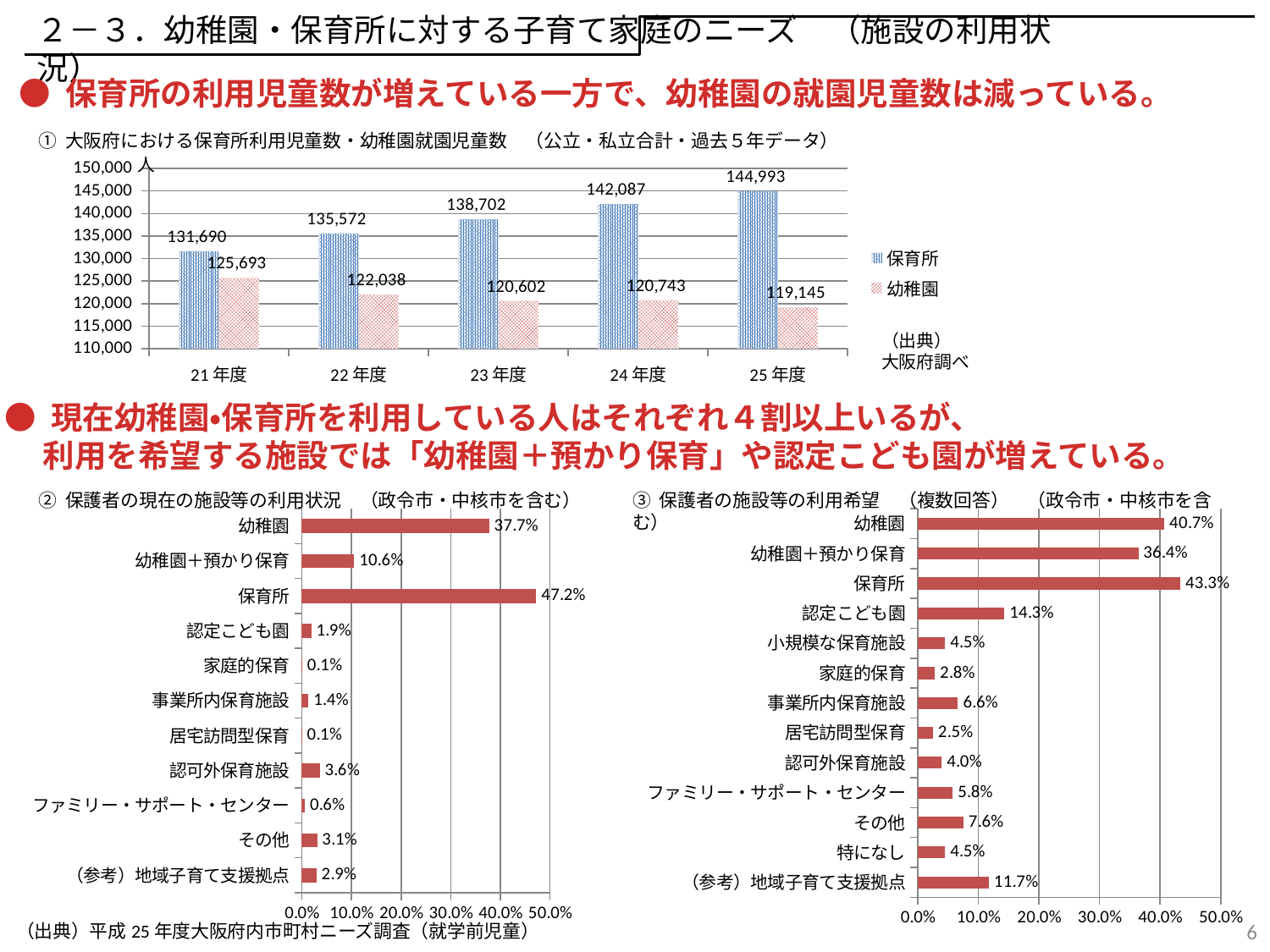
In chart ① (大阪府における保育所利用児童数・幼稚園就園児童数), how many series does the legend list? 2 In chart ③ (保護者の施設等の利用希望), which is larger, 幼稚園 or 保育所? 保育所 In chart ① (大阪府における保育所利用児童数・幼稚園就園児童数), in which year is 幼稚園 lowest? 25年度 In chart ② (保護者の現在の施設等の利用状況), how many categories are shown? 11 In chart ① (大阪府における保育所利用児童数・幼稚園就園児童数), what is the value for 保育所 in 25年度? 144,993 In chart ① (大阪府における保育所利用児童数・幼稚園就園児童数), what is the difference between 保育所 and 幼稚園 in 23年度? 18,100 In chart ① (大阪府における保育所利用児童数・幼稚園就園児童数), what is the value for 幼稚園 in 21年度? 125,693 In chart ③ (保護者の施設等の利用希望), what is the value for 認定こども園? 14.3% In chart ② (保護者の現在の施設等の利用状況), what is the value for 幼稚園＋預かり保育? 10.6% In chart ① (大阪府における保育所利用児童数・幼稚園就園児童数), does the 保育所 series rise or fall from 21年度 to 25年度? rise What kind of chart is chart ③ (保護者の施設等の利用希望)? bar chart In chart ② (保護者の現在の施設等の利用状況), which category has the highest value? 保育所